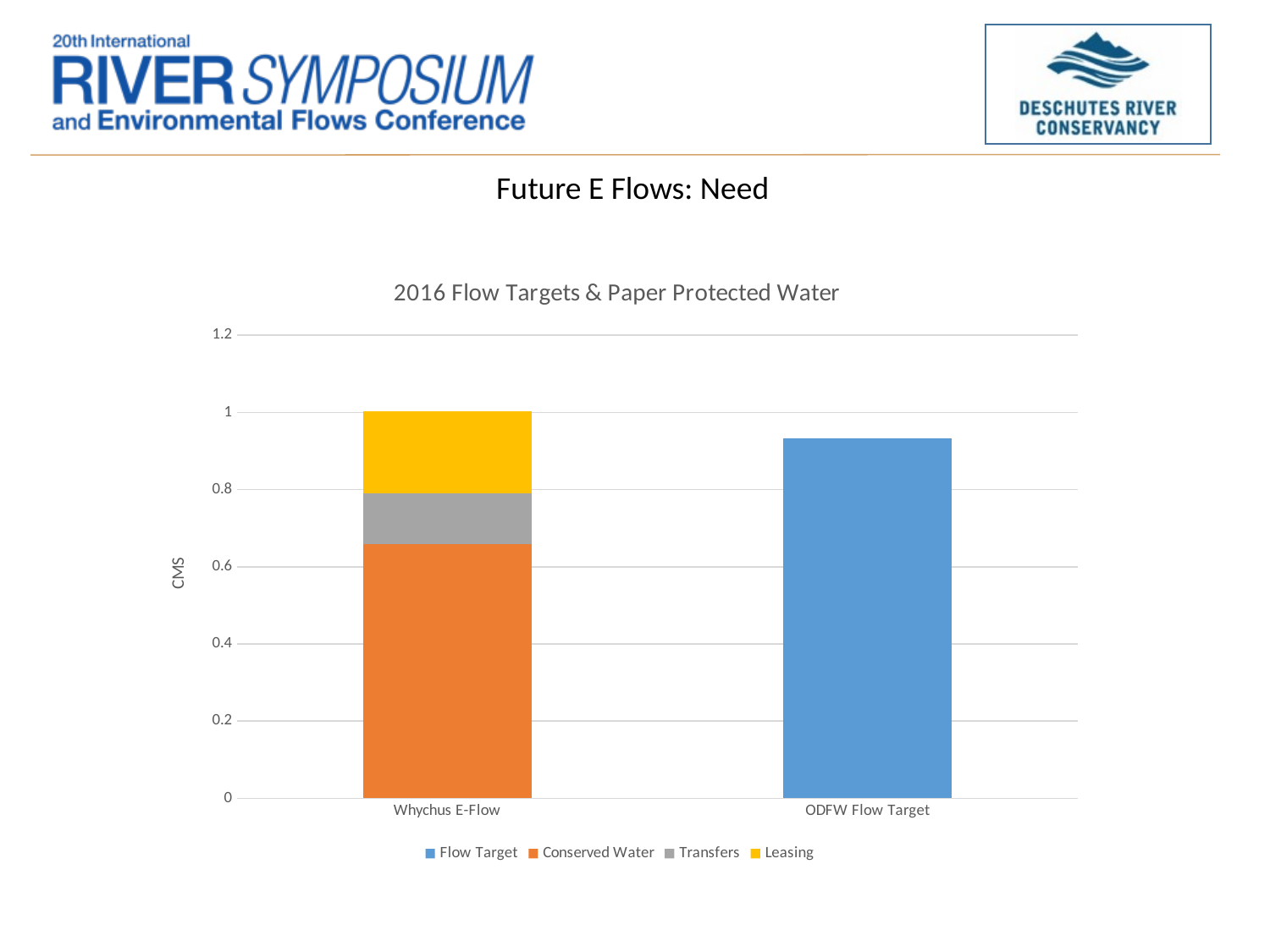
What is the title of the chart? 2016 Flow Targets & Paper Protected Water Is the value for ODFW Flow Target greater or less than 0.8? greater Is the Transfers segment of the Whychus E-Flow bar greater or less than 0.2? less How many series does the chart legend list? 4 What kind of chart is shown on the slide? bar chart Is the value for ODFW Flow Target greater or less than 1? less How many categories are shown on the x axis of the chart? 2 Which category has the taller bar, Whychus E-Flow or ODFW Flow Target? Whychus E-Flow Which series makes up the largest part of the Whychus E-Flow bar? Conserved Water What is the label on the vertical axis of the chart? CMS